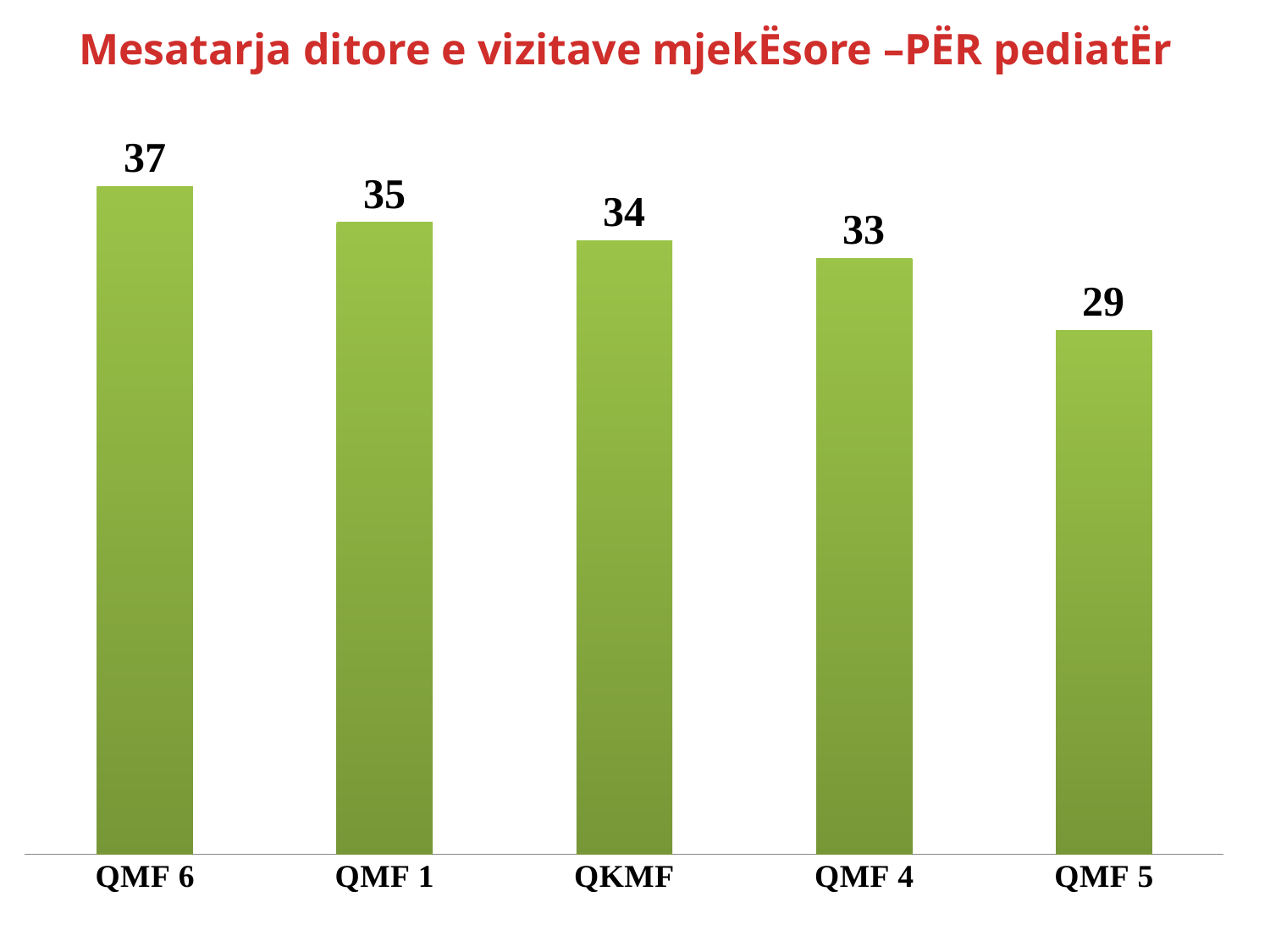
Which category has the highest value? QMF 6 What is the value for QKMF? 34 Do the values rise or fall from left to right along the x axis? fall How many categories are shown in the chart? 5 What is the value for QMF 5? 29 What kind of chart is shown on the slide? bar chart What is the value for QMF 6? 37 Which is larger, the value for QMF 1 or the value for QMF 5? QMF 1 What is the value for QMF 4? 33 What is the difference between the values for QMF 6 and QMF 5? 8 Which category has the lowest value? QMF 5 What is the difference between the values for QMF 1 and QMF 4? 2